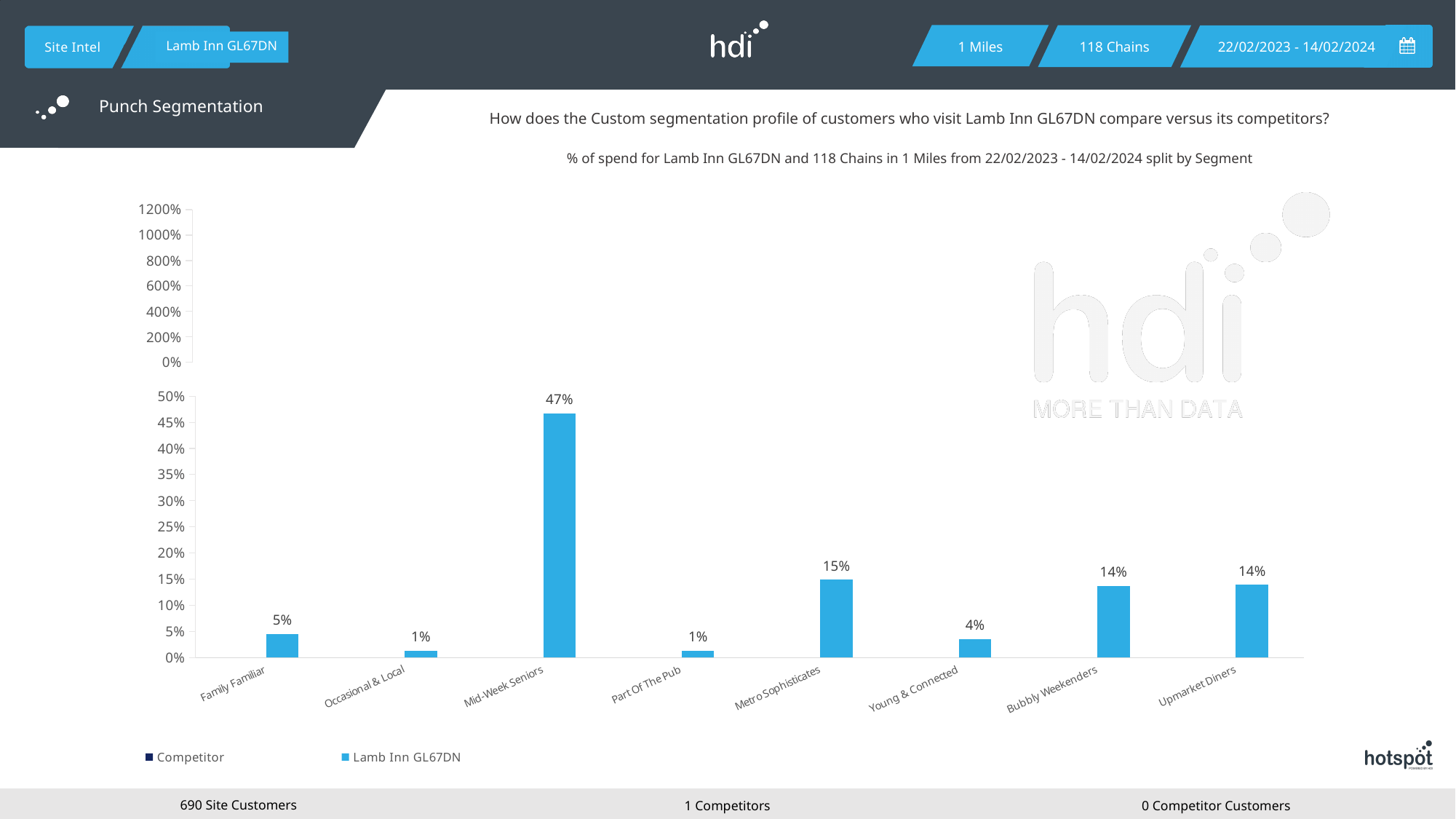
In the lower chart, which segment has the highest value? Mid-Week Seniors In the lower chart, what is the difference between the values for Bubbly Weekenders and Family Familiar? 9% In the lower chart, is the value for Mid-Week Seniors greater or less than 40%? greater How many segment categories are shown on the x axis of the lower chart? 8 In the lower chart, which is larger, the value for Family Familiar or the value for Occasional & Local? Family Familiar In the lower chart, what is the value for Metro Sophisticates? 15% In the lower chart, what is the difference between the values for Mid-Week Seniors and Metro Sophisticates? 32% How many series does the legend list? 2 What type of chart is shown on the slide? bar chart In the lower chart, what is the value for Young & Connected? 4% In the lower chart, what is the value for Mid-Week Seniors? 47% In the lower chart, what is the value for Family Familiar? 5%